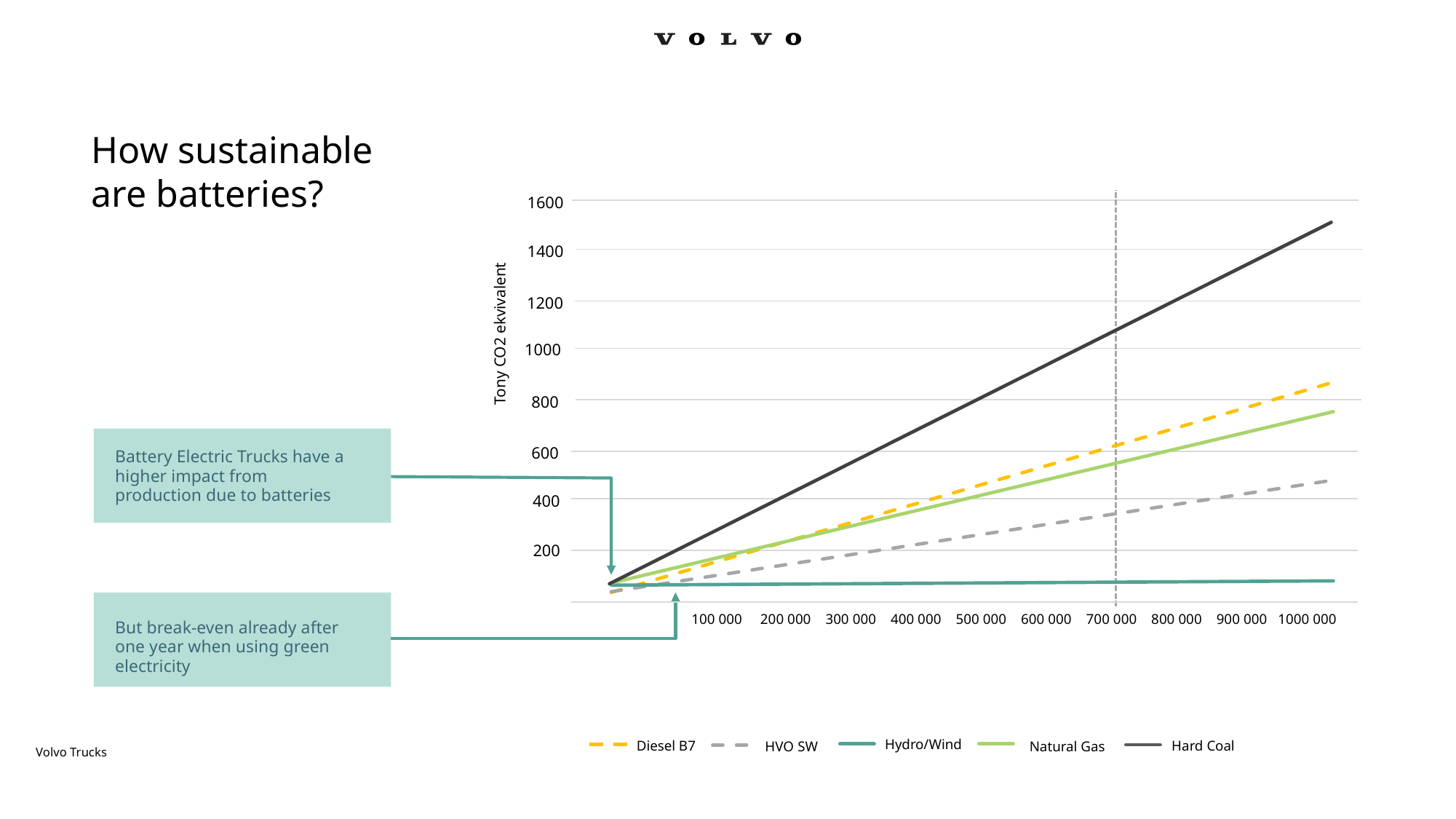
Which series has the lowest value at 1000 000 on the x axis? Hydro/Wind At 1000 000 on the x axis, which is larger: Diesel B7 or Natural Gas? Diesel B7 What kind of chart is shown on the slide? line chart Is the value for Hard Coal at 500 000 greater or less than 600? greater Is the value for Hard Coal at 1000 000 greater or less than 1400? greater Which series has the highest value at 1000 000 on the x axis? Hard Coal Which series is drawn with a dashed grey line? HVO SW Does the Hard Coal line rise or fall as the x-axis value increases? rise What is the label of the y axis? Tony CO2 ekvivalent How many series does the legend list? 5 Is the value for Natural Gas at 1000 000 greater or less than 800? less